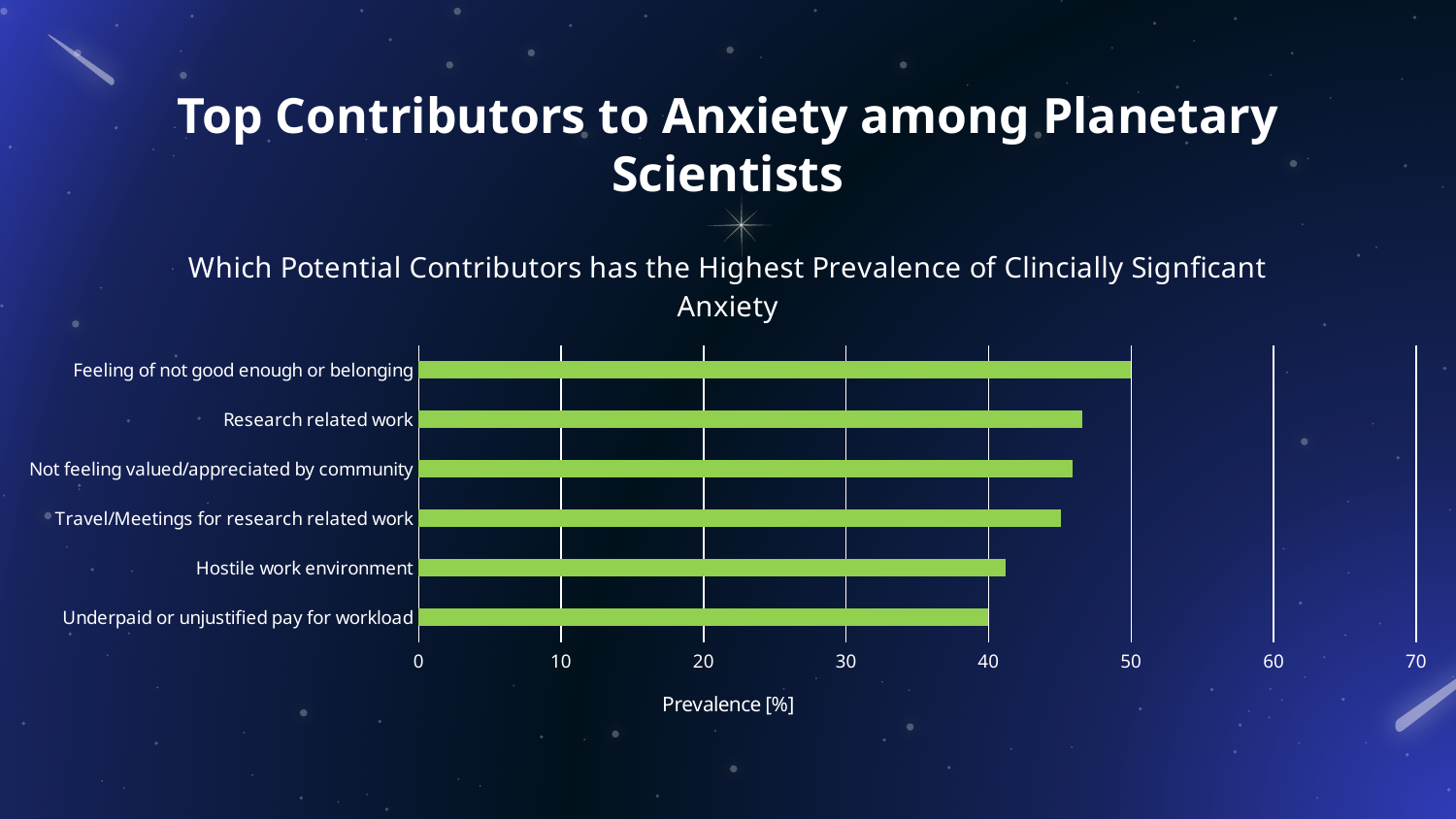
What kind of chart is shown on the slide? Bar chart Is the value for 'Feeling of not good enough or belonging' greater or less than 40? greater What is the label of the horizontal axis of the chart? Prevalence [%] How many contributors (categories) are plotted in the chart? 6 Which contributor has the highest prevalence in the chart? Feeling of not good enough or belonging What is the highest tick value shown on the horizontal axis? 70 Which has a larger value: 'Research related work' or 'Hostile work environment'? Research related work Which has a larger value: 'Feeling of not good enough or belonging' or 'Underpaid or unjustified pay for workload'? Feeling of not good enough or belonging Is the value for 'Underpaid or unjustified pay for workload' greater or less than 50? less Is the value for 'Research related work' greater or less than 40? greater